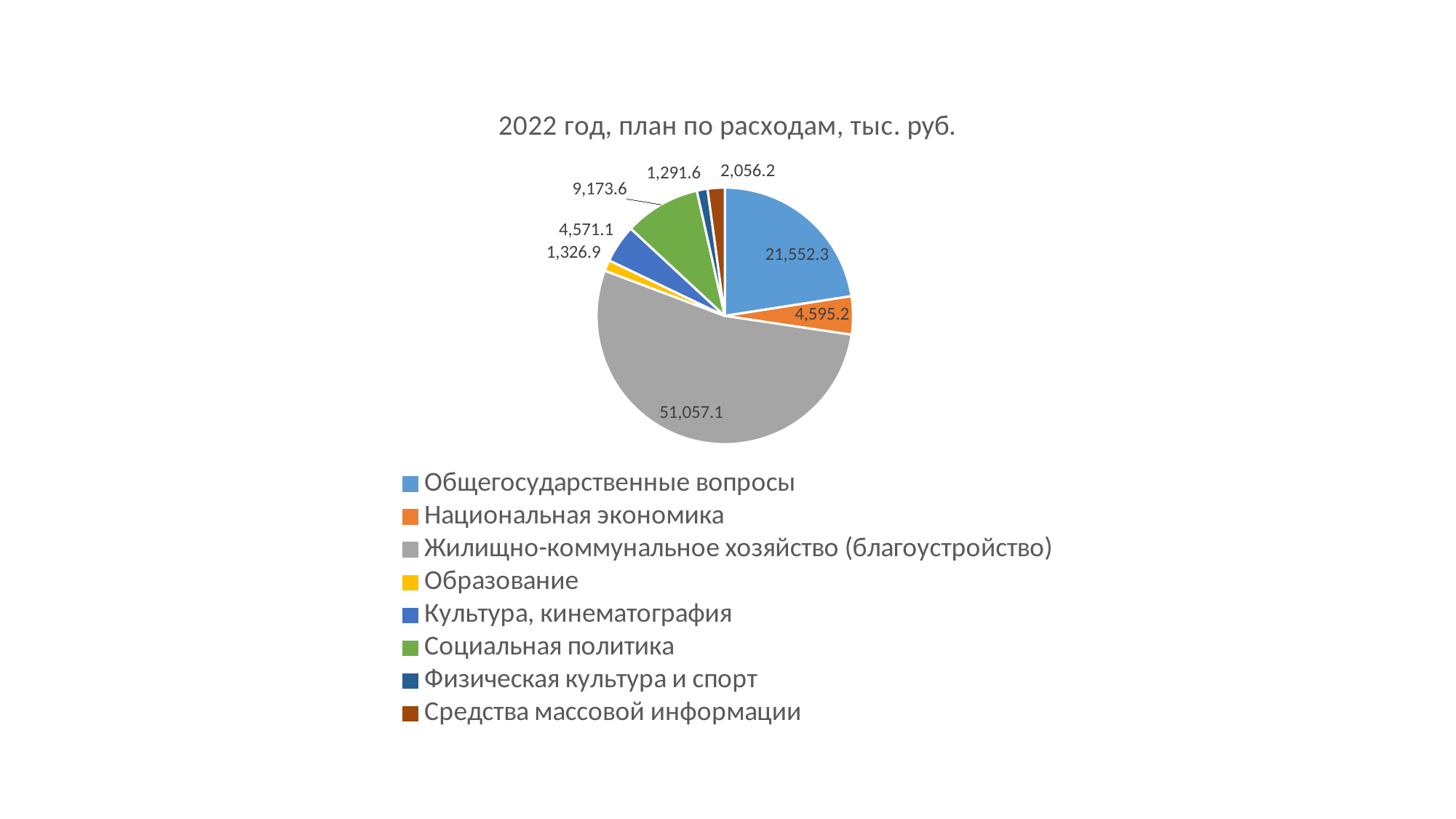
What is the title of the chart? 2022 год, план по расходам, тыс. руб. What is the value for Общегосударственные вопросы? 21,552.3 What is the value for Жилищно-коммунальное хозяйство (благоустройство)? 51,057.1 Which is larger, Общегосударственные вопросы or Социальная политика? Общегосударственные вопросы What is the difference between Жилищно-коммунальное хозяйство (благоустройство) and Общегосударственные вопросы? 29,504.8 How many entries does the legend list? 8 How many slices does the pie chart have? 8 Which category has the largest slice? Жилищно-коммунальное хозяйство (благоустройство) What is the value for Средства массовой информации? 2,056.2 What is the value for Социальная политика? 9,173.6 What type of chart is shown on the slide? pie chart What colour is the slice for Образование? yellow